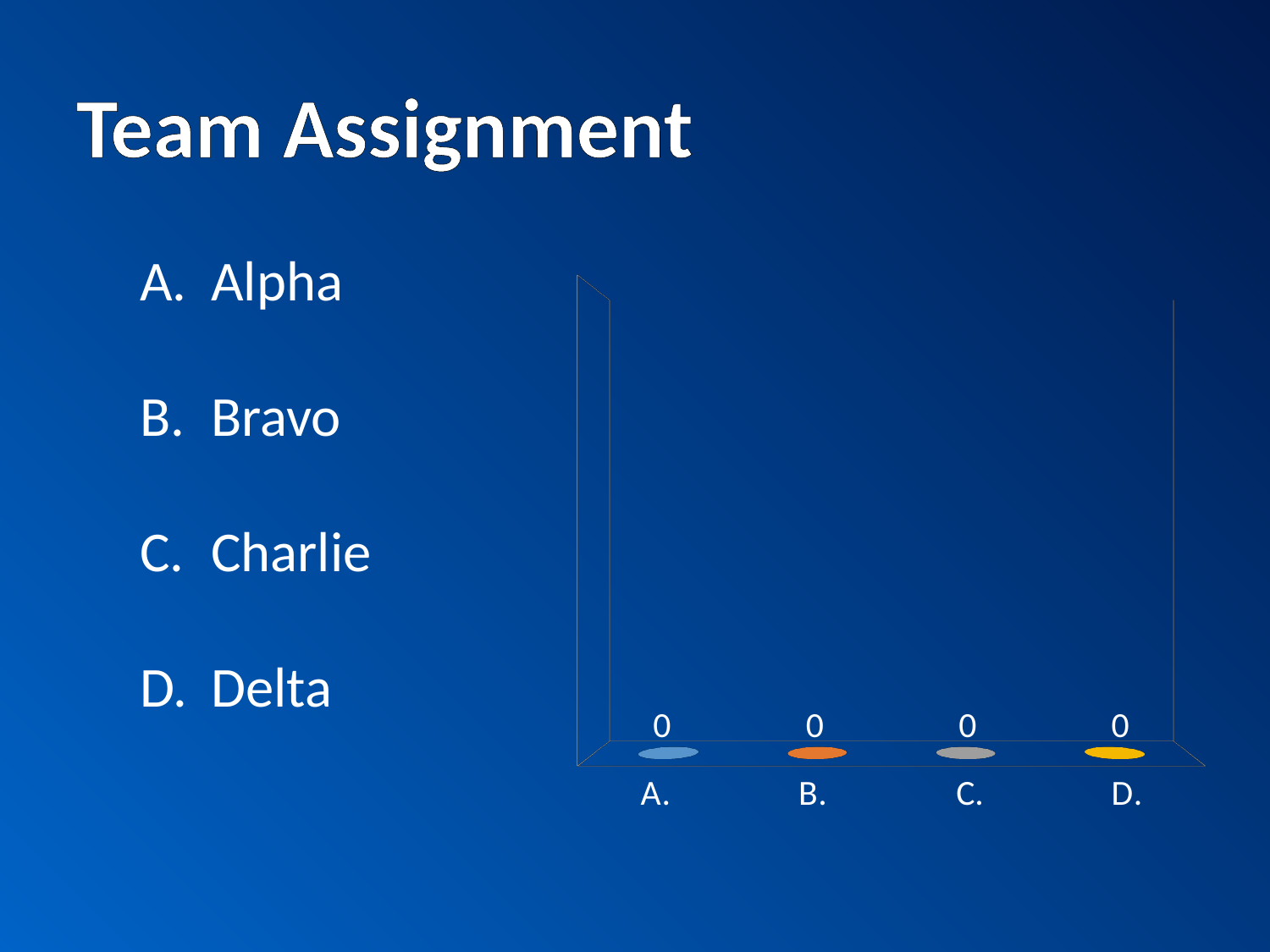
What is the value for category D. in the chart? 0 What are the category labels on the x axis of the chart, in order? A., B., C., D. What is the value for category A. in the chart? 0 What is the value for category B. in the chart? 0 How many categories are shown on the x axis of the chart? 4 What is the difference between the values for A. and D.? 0 What kind of chart is shown on the slide? bar chart Do the values rise, fall, or stay the same from A. to D.? stay the same What colour is the bar for category B.? orange What is the value for category C. in the chart? 0